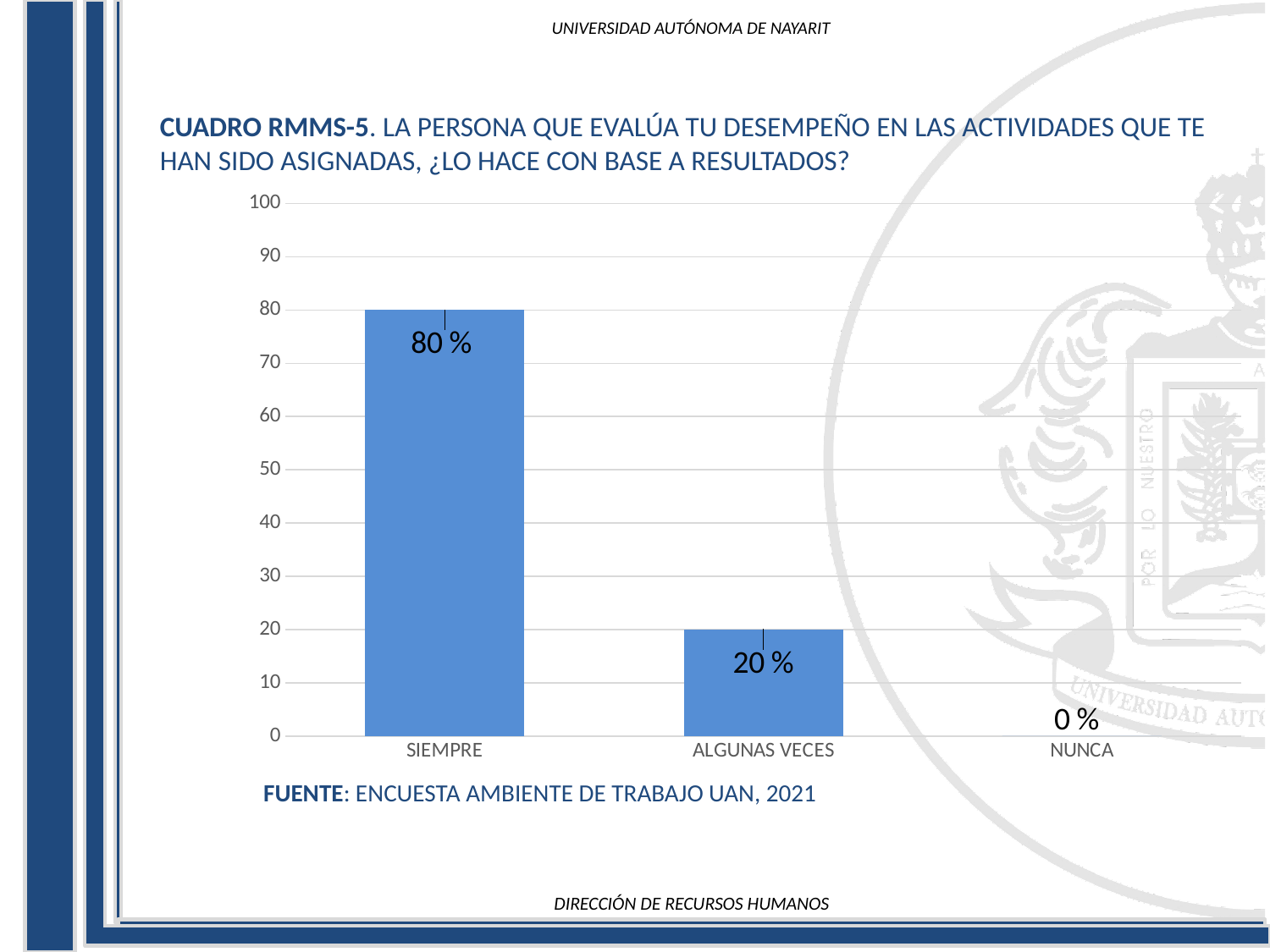
What is the source cited below the chart? ENCUESTA AMBIENTE DE TRABAJO UAN, 2021 Which is larger, the value for ALGUNAS VECES or the value for NUNCA? ALGUNAS VECES What is the value for NUNCA? 0 % How many categories are shown on the x axis? 3 What is the value for ALGUNAS VECES? 20 % Which category has the highest value? SIEMPRE Which category has the lowest value? NUNCA Do the values rise or fall from left to right along the x axis? fall Is the value for SIEMPRE greater or less than 50? greater What is the difference between the values for SIEMPRE and ALGUNAS VECES? 60 % What kind of chart is shown on the slide? bar chart What is the value for SIEMPRE? 80 %